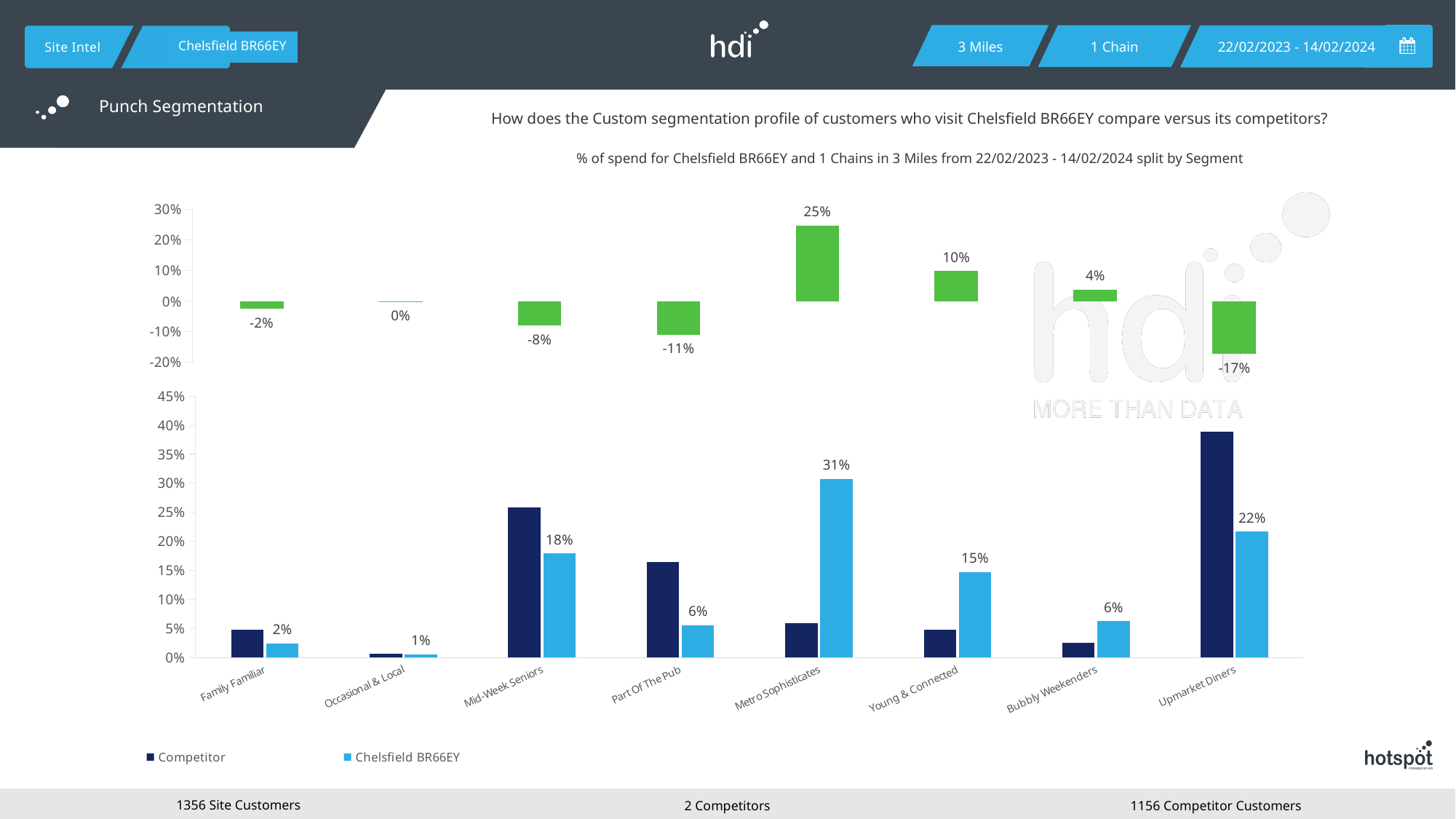
How many segments are shown on the x axis of the bottom chart? 8 In the top chart, what is the difference between the values for Metro Sophisticates and Young & Connected? 15 percentage points How many series does the legend of the bottom chart list? 2 In the top chart, which segment has the highest value? Metro Sophisticates In the top chart, which segment has the lowest value? Upmarket Diners In the bottom chart, is the Competitor value for Upmarket Diners greater or less than 35%? greater In the top chart, what is the value shown for Part Of The Pub? -11% In the bottom chart, what is the Chelsfield BR66EY value for Upmarket Diners? 22% In the bottom chart, is the Competitor value for Mid-Week Seniors greater or less than 20%? greater In the bottom chart, for Mid-Week Seniors, which series has the larger value: Competitor or Chelsfield BR66EY? Competitor In the top chart, what is the value shown for Metro Sophisticates? 25% In the bottom chart, what is the Chelsfield BR66EY value for Metro Sophisticates? 31%